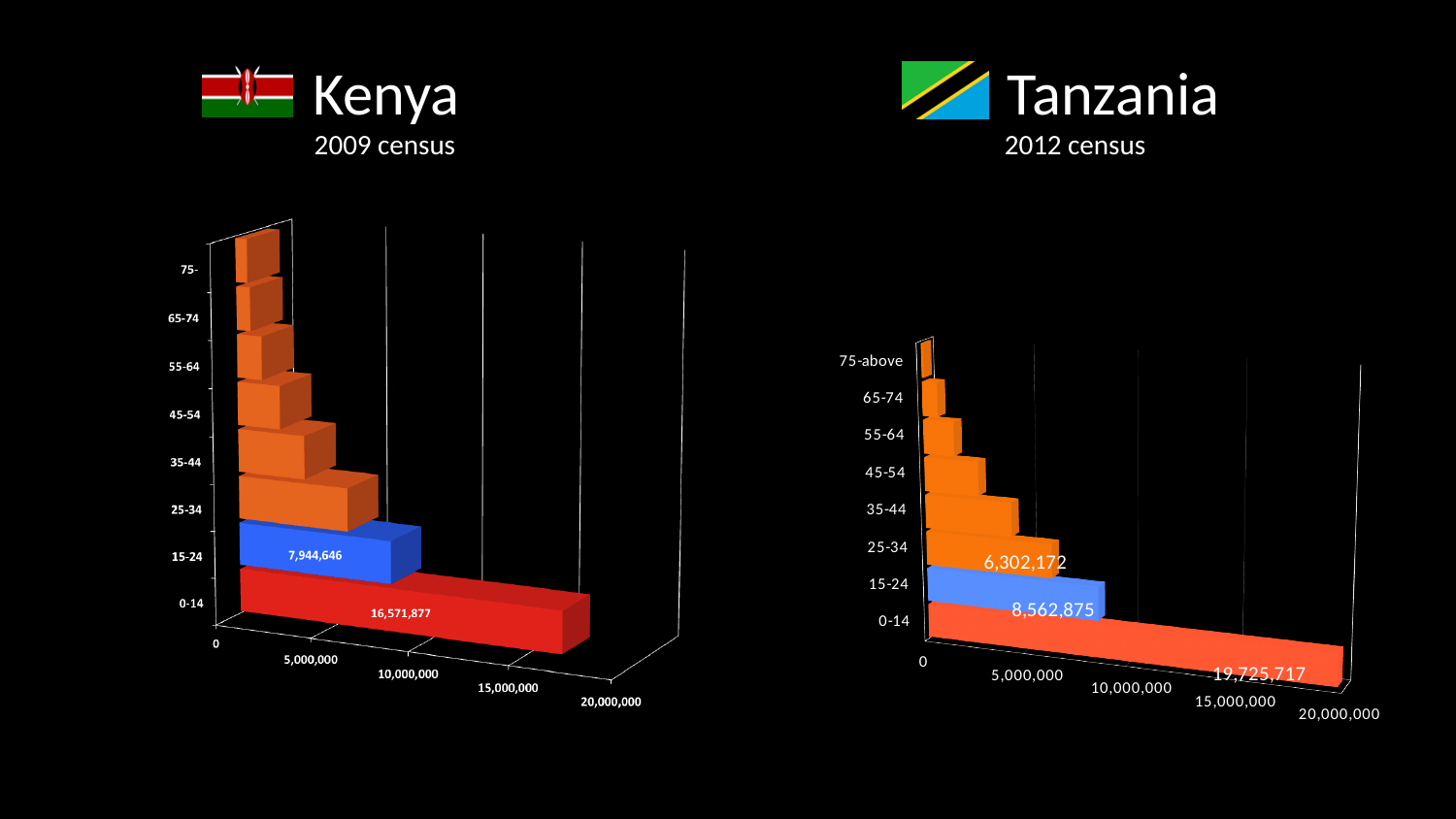
On the Tanzania chart, what is the difference between the 15-24 and 25-34 values? 2,260,703 On the Tanzania chart, what is the value for the 25-34 age group? 6,302,172 How many age groups are shown on the Kenya chart? 8 On the Tanzania chart, is the value for the 45-54 age group greater or less than 5,000,000? less On the Tanzania chart, what is the value for the 0-14 age group? 19,725,717 On the Tanzania chart, which age group has the smallest population? 75-above On the Kenya chart, what is the value for the 0-14 age group? 16,571,877 On the Kenya chart, which age group has the largest population? 0-14 On the Tanzania chart, what is the value for the 15-24 age group? 8,562,875 What kind of chart is the Tanzania chart? bar chart On the Kenya chart, what is the value for the 15-24 age group? 7,944,646 On the Kenya chart, what is the difference between the 0-14 and 15-24 values? 8,627,231